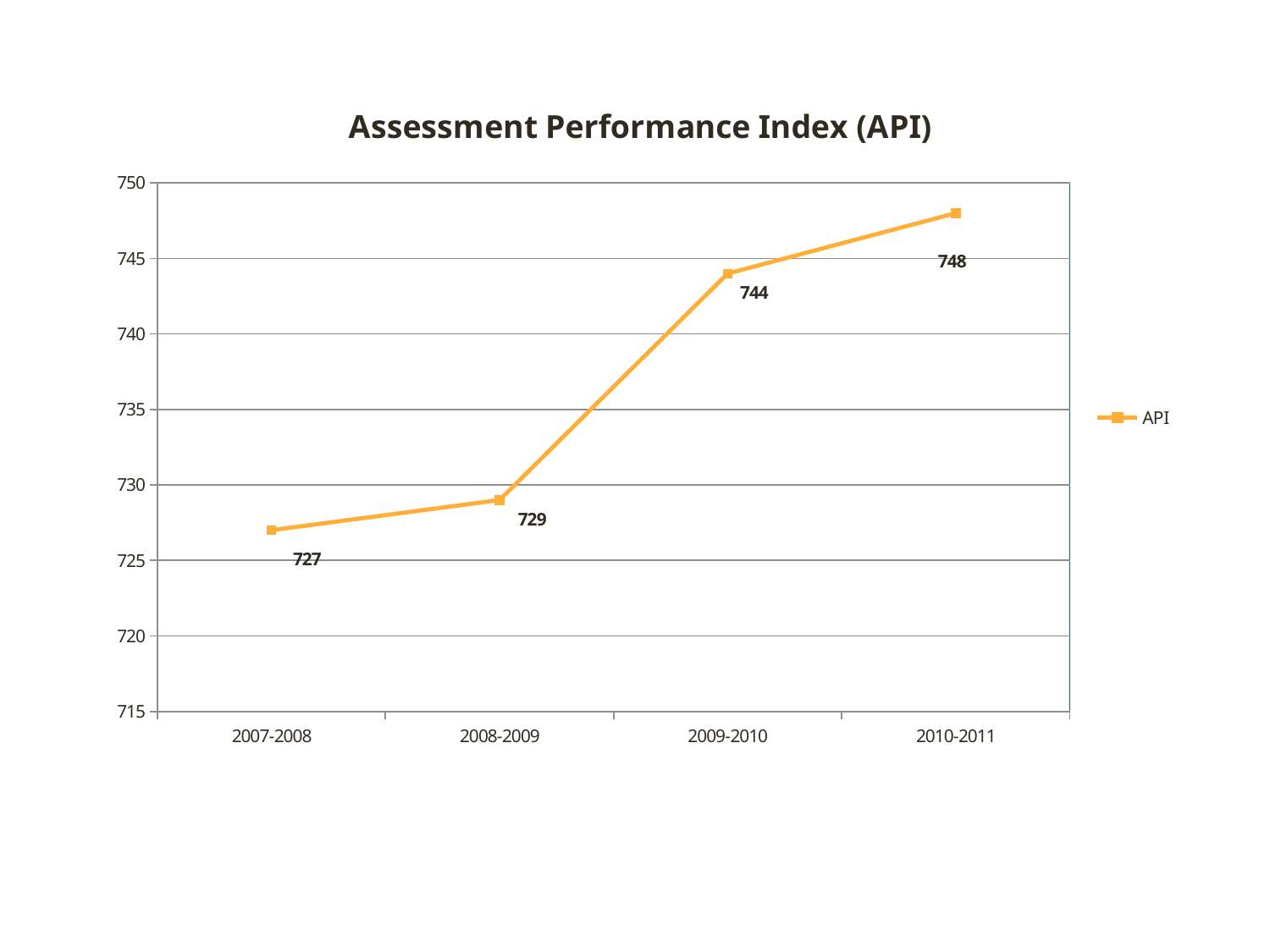
Do the API values rise or fall from 2007-2008 to 2010-2011? rise How many years are plotted on the chart? 4 Which year has the highest API value? 2010-2011 What is the API value for 2007-2008? 727 What is the difference between the API values for 2009-2010 and 2008-2009? 15 What is the API value for 2010-2011? 748 Which is larger, the API value for 2008-2009 or for 2009-2010? 2009-2010 Is the API value for 2008-2009 greater or less than 730? less What is the difference between the API values for 2010-2011 and 2007-2008? 21 What is the API value for 2009-2010? 744 Which year has the lowest API value? 2007-2008 What kind of chart is shown on the slide? line chart